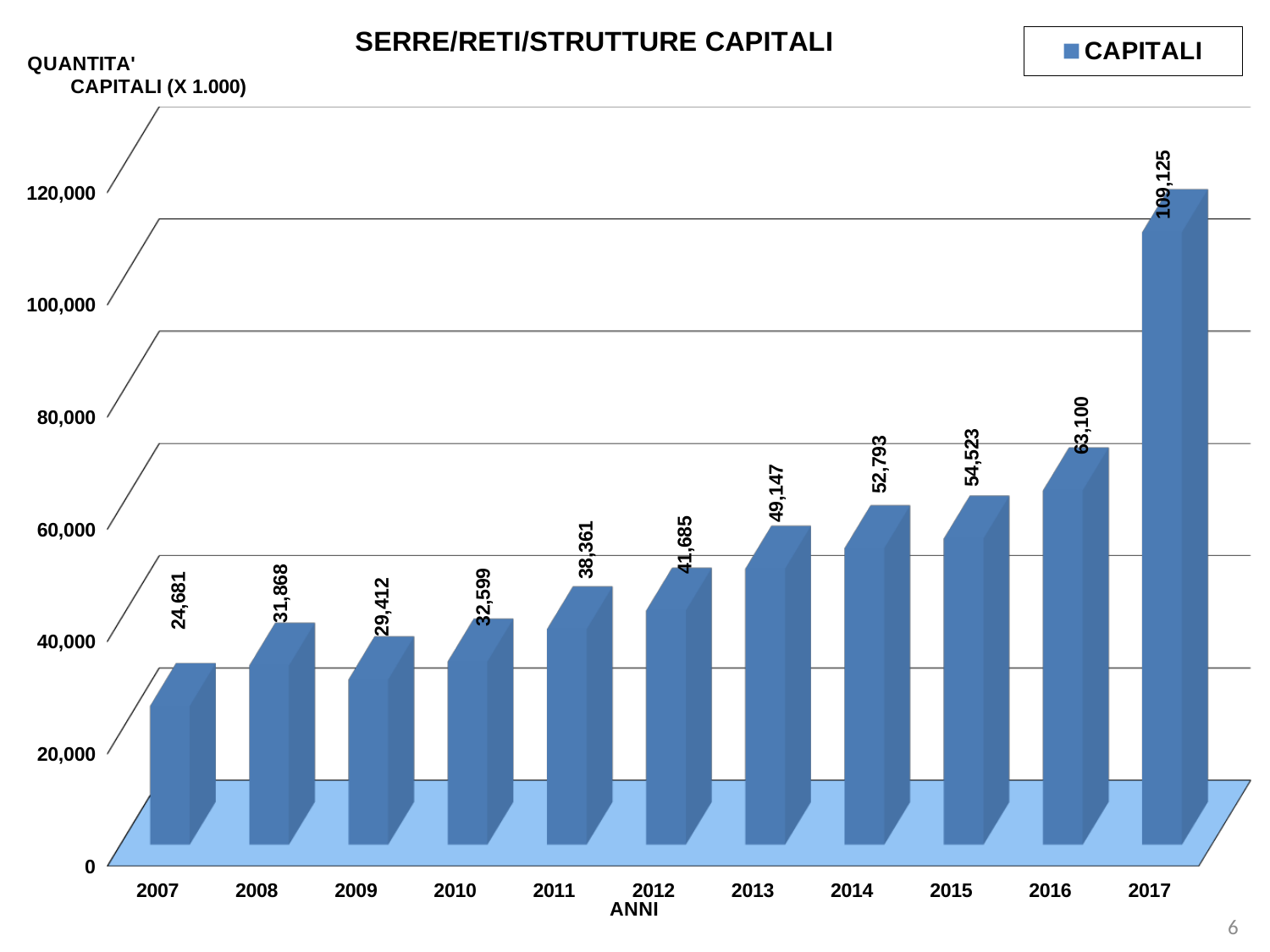
Which year has the highest value? 2017 Which is larger, the value for 2008 or the value for 2009? 2008 What is the title of the chart? SERRE/RETI/STRUTTURE CAPITALI What is the value for 2013? 49,147 What is the value for 2007? 24,681 How many years are shown on the x axis? 11 How many series does the legend list? 1 What kind of chart is shown? bar chart What is the difference between the values for 2017 and 2016? 46,025 What is the difference between the values for 2008 and 2007? 7,187 Which year has the lowest value? 2007 What is the value for 2017? 109,125